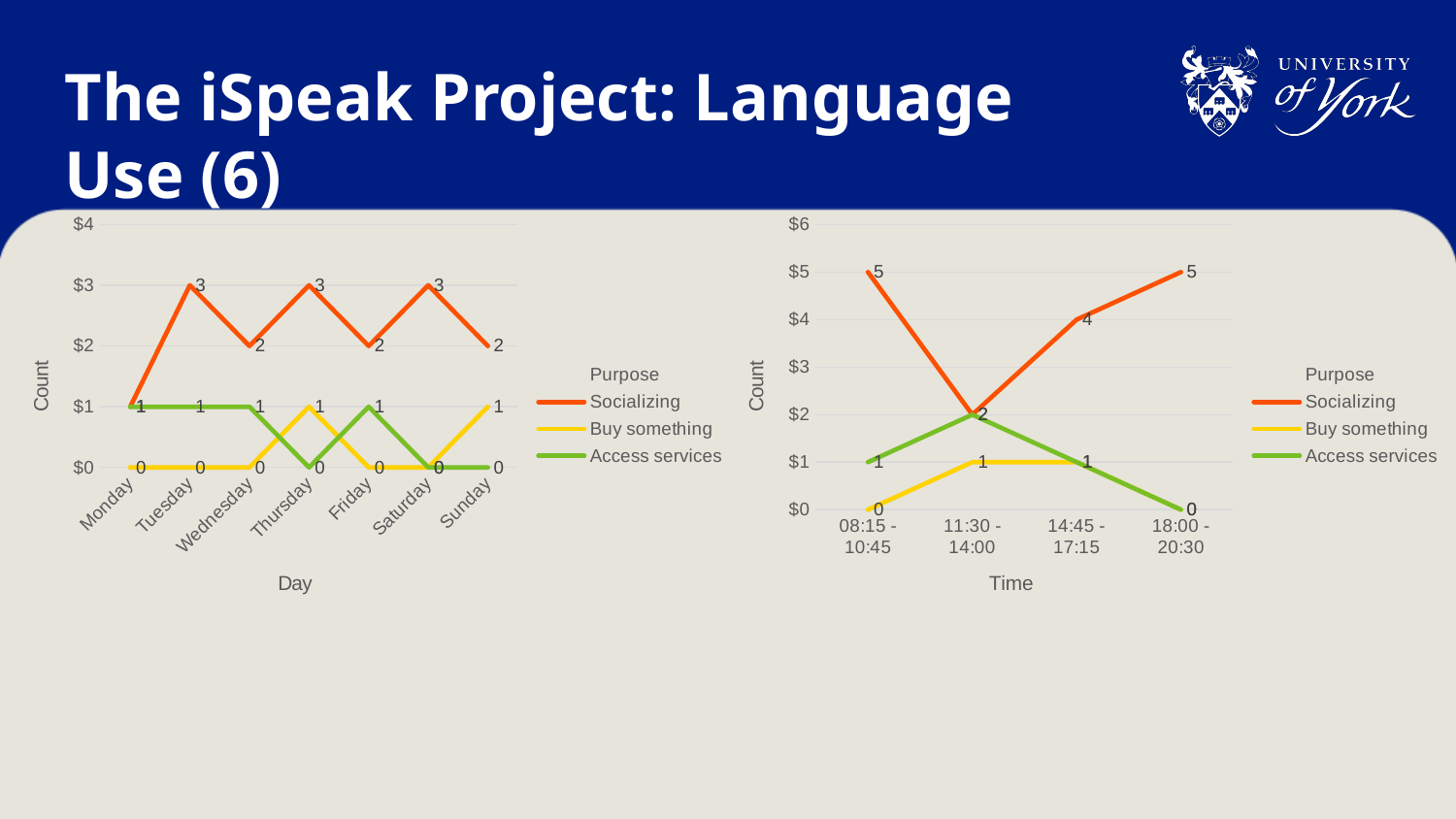
In the right chart, what is the Socializing value for 14:45 - 17:15? 4 In the left chart, what is the Socializing value on Monday? 1 In the left chart, how many days are shown on the x axis? 7 In the right chart, which time slot has the lowest Socializing value? 11:30 - 14:00 In the left chart, what is the difference between the Socializing values on Tuesday and Wednesday? 1 In the right chart, what is the difference between the Socializing values for 08:15 - 10:45 and 11:30 - 14:00? 3 In the left chart, what is the Buy something value on Thursday? 1 In the right chart, what is the Socializing value for 11:30 - 14:00? 2 How many series does the legend of the left chart list? 3 In the right chart, which series is drawn in green according to the legend? Access services In the left chart, what is the Socializing value on Tuesday? 3 What kind of chart is the left chart on the slide? line chart